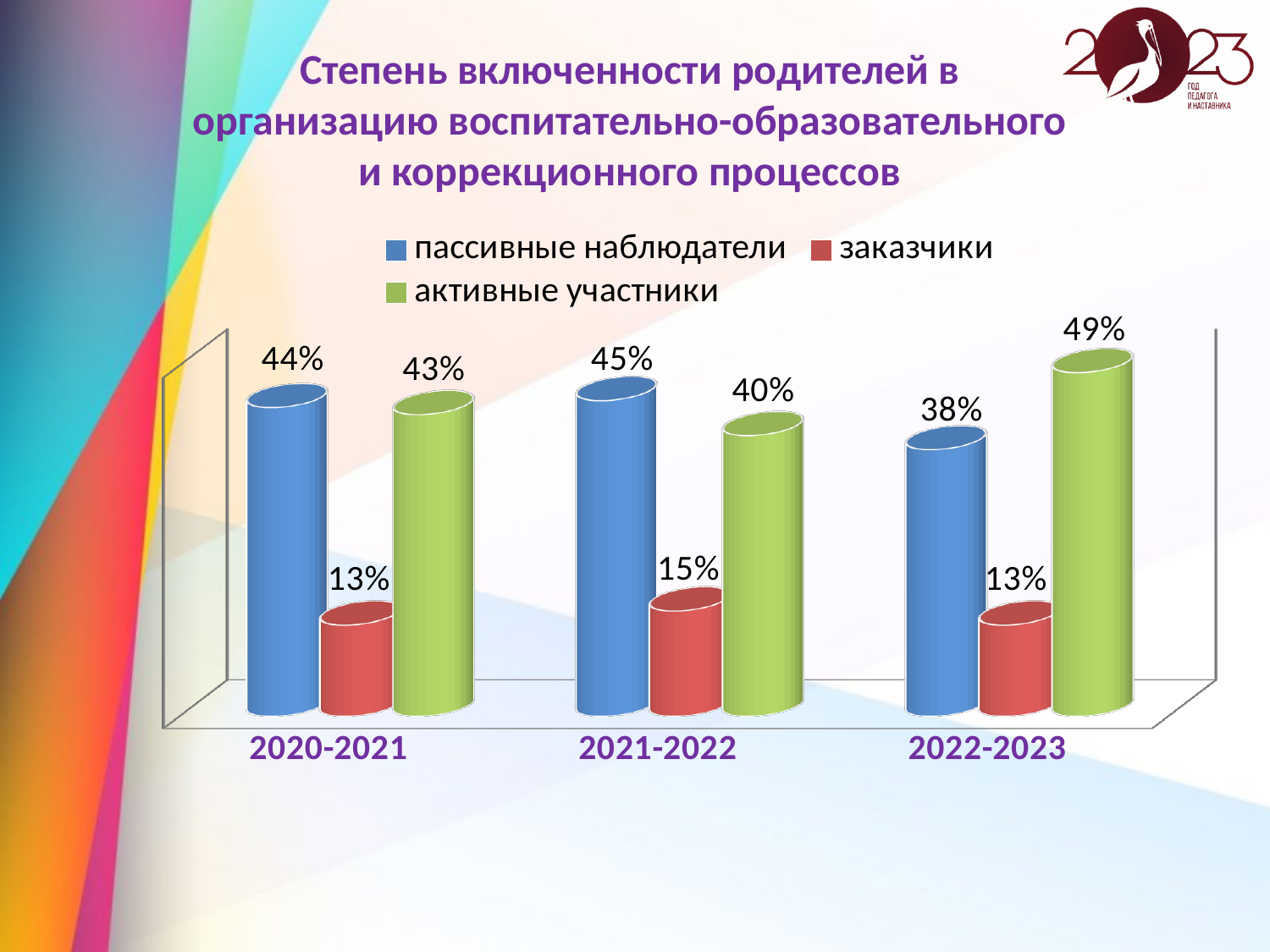
Which colour represents заказчики in the chart? Red What is the value for пассивные наблюдатели in 2022-2023? 38% Which is larger in 2021-2022: пассивные наблюдатели or активные участники? пассивные наблюдатели What is the difference between активные участники and пассивные наблюдатели in 2022-2023? 11% How many series does the legend list? 3 What kind of chart is shown on the slide? Bar chart In which period is the value for активные участники highest? 2022-2023 How many periods are shown on the x axis? 3 What is the value for заказчики in 2021-2022? 15% What is the value for активные участники in 2022-2023? 49% What is the value for пассивные наблюдатели in 2020-2021? 44% In which period is the value for пассивные наблюдатели lowest? 2022-2023